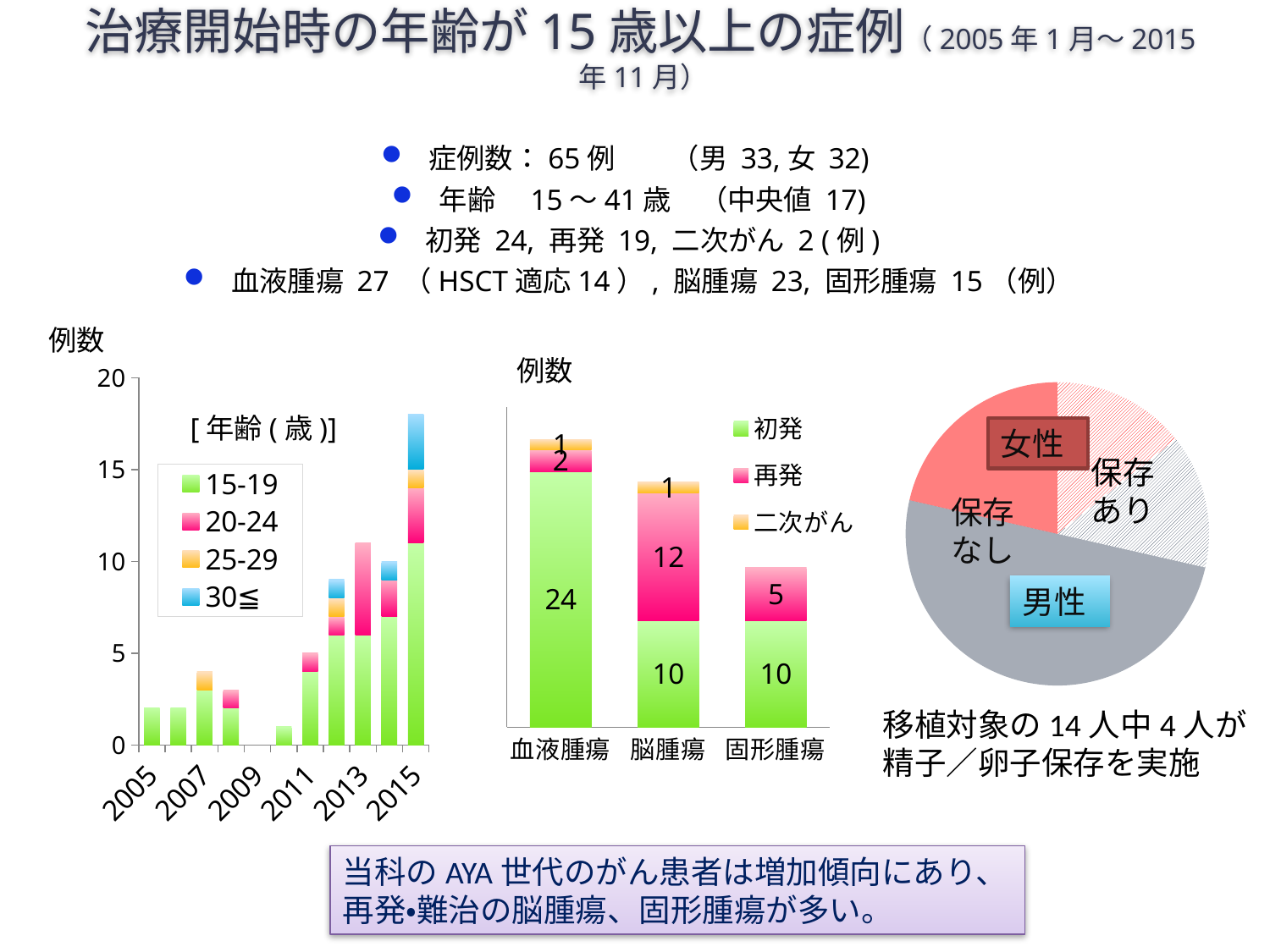
What kind of chart is the chart on the right showing 男性 and 女性? pie chart In the middle stacked bar chart by tumor type, how many series does the legend list? 3 In the middle stacked bar chart by tumor type, what is the total of the 脳腫瘍 bar? 23 In the left bar chart by year, which year has the highest bar? 2015 In the middle stacked bar chart by tumor type, what is the value of 再発 for 固形腫瘍? 5 In the middle stacked bar chart by tumor type, what is the difference between 初発 for 血液腫瘍 and 初発 for 脳腫瘍? 14 In the middle stacked bar chart by tumor type, what is the total of the 固形腫瘍 bar? 15 In the middle stacked bar chart by tumor type, which is larger for 脳腫瘍: 初発 or 再発? 再発 In the middle stacked bar chart by tumor type, what is the value of 初発 for 血液腫瘍? 24 In the left bar chart by year, how many age-group series does the legend list? 4 In the left bar chart by year, is the total value for 2015 greater or less than 15? greater In the middle stacked bar chart by tumor type, what is the value of 再発 for 脳腫瘍? 12